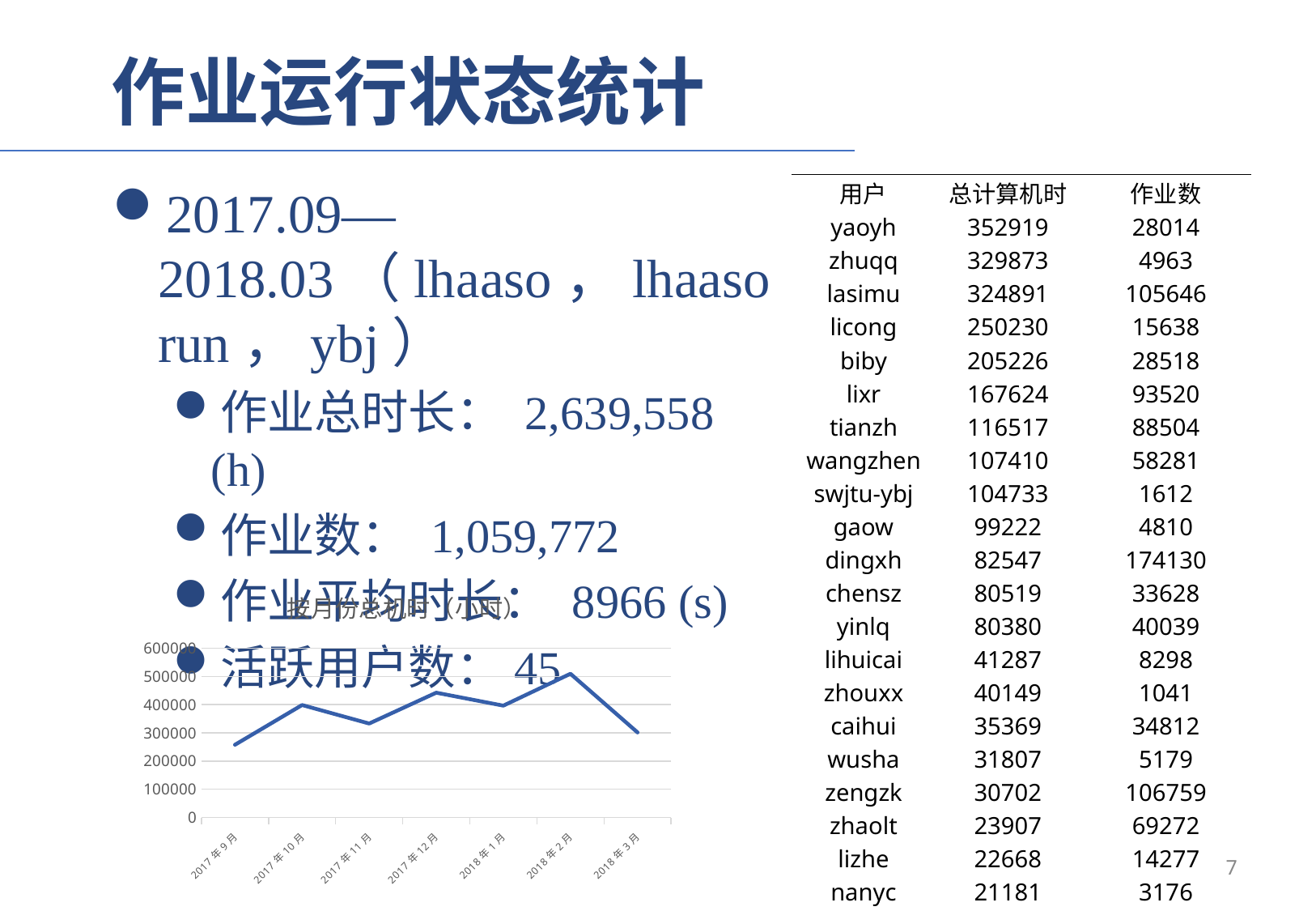
What kind of chart is shown on the slide? line chart Does the line rise or fall from 2018年2月 to 2018年3月? fall Is the value for 2017年10月 greater or less than 300000? greater What is the highest tick value shown on the y axis of the line chart? 600000 How many months are plotted on the x axis of the line chart? 7 Which is larger in the line chart, the value for 2017年12月 or the value for 2017年9月? 2017年12月 Which month has the highest value in the line chart? 2018年2月 Is the value for 2018年2月 greater or less than 400000? greater Is the value for 2017年9月 greater or less than 300000? less Which is larger in the line chart, the value for 2018年2月 or the value for 2017年11月? 2018年2月